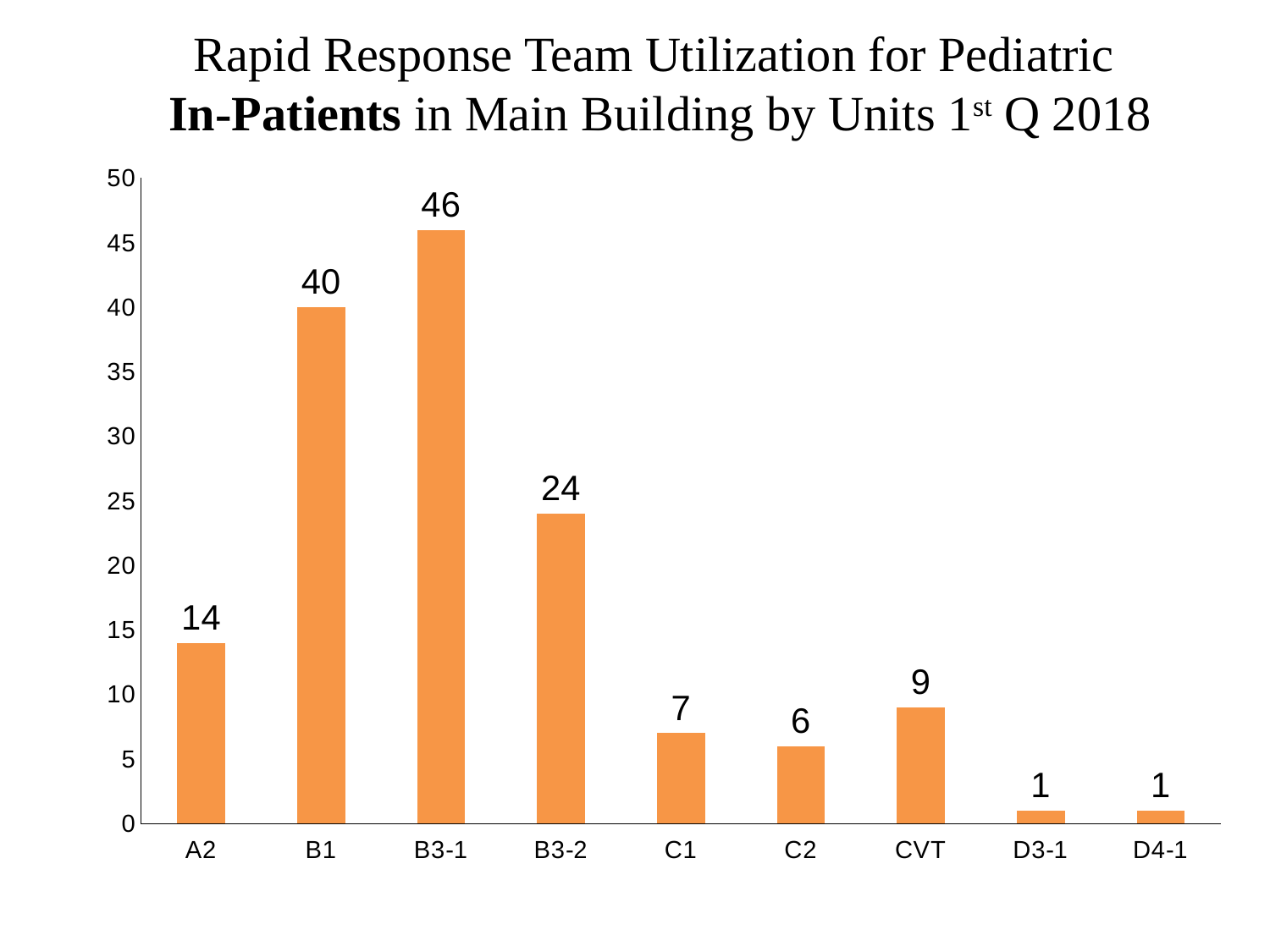
Is the value for B3-2 greater or less than 20? greater Which is larger, the value for C1 or the value for C2? C1 What is the value for B1? 40 What is the value for CVT? 9 What is the difference between the values for B3-1 and B3-2? 22 Which units have the lowest value? D3-1 and D4-1 What kind of chart is this? Bar chart Which unit has the highest value? B3-1 What is the difference between the values for B1 and A2? 26 How many units are shown on the x axis? 9 What is the title of the chart? Rapid Response Team Utilization for Pediatric In-Patients in Main Building by Units 1st Q 2018 What is the value for A2? 14